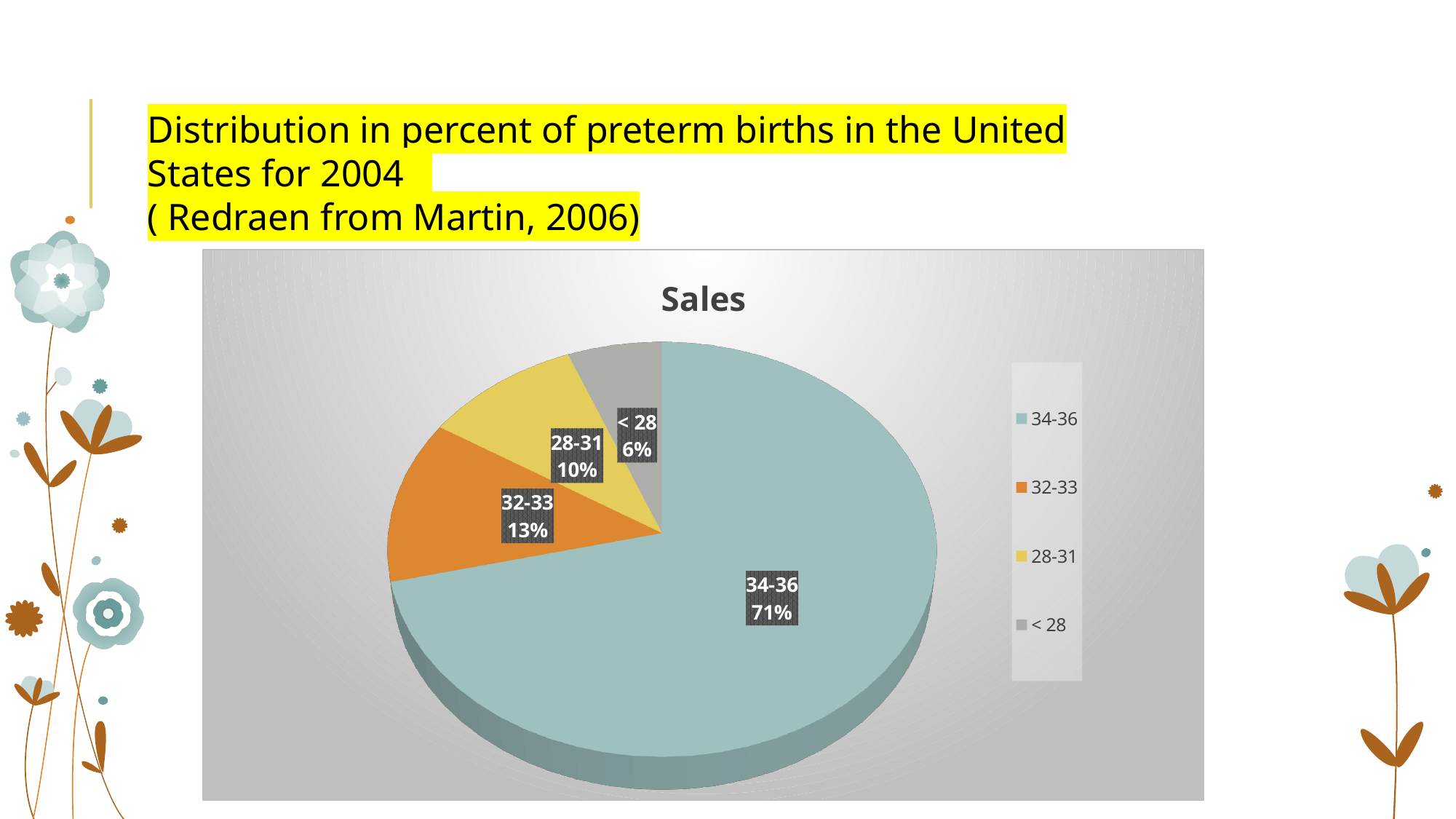
Which category has the smallest slice of the pie? < 28 Which is larger, the 28-31 slice or the < 28 slice? 28-31 What percentage does the 32-33 slice show? 13% What is the difference in percentage points between the 32-33 slice and the 28-31 slice? 3 What is the chart's title? Sales What percentage does the < 28 slice show? 6% Which category has the largest slice of the pie? 34-36 How many entries does the legend list? 4 How many categories does the pie chart have? 4 What kind of chart is shown on the slide? pie chart What percentage does the 34-36 slice show? 71% What percentage does the 28-31 slice show? 10%